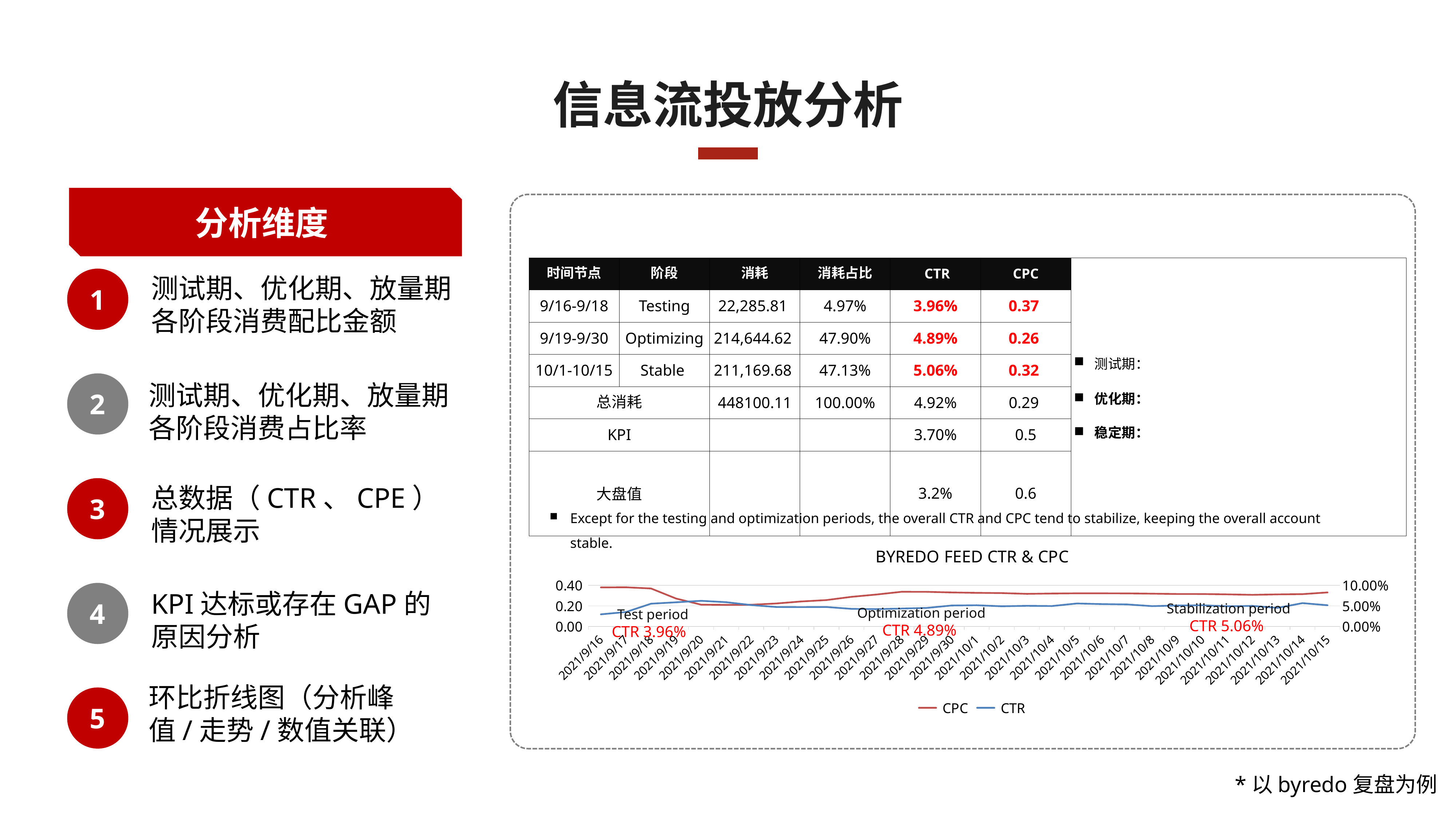
In the BYREDO FEED CTR & CPC chart, is the CPC value on 2021/9/16 greater or less than 0.20? greater How many dates are plotted along the x axis of the BYREDO FEED CTR & CPC chart? 30 How many series does the legend of the BYREDO FEED CTR & CPC chart list? 2 In the BYREDO FEED CTR & CPC chart, which annotated period has the higher CTR: the Test period or the Stabilization period? Stabilization period In the BYREDO FEED CTR & CPC chart, what CTR value is annotated for the Stabilization period? 5.06% In the BYREDO FEED CTR & CPC chart, what CTR value is annotated for the Test period? 3.96% In the BYREDO FEED CTR & CPC chart, what is the difference between the annotated Stabilization period CTR and the Test period CTR? 1.10% What is the title of the line chart on the slide? BYREDO FEED CTR & CPC In the BYREDO FEED CTR & CPC chart, what CTR value is annotated for the Optimization period? 4.89% In the BYREDO FEED CTR & CPC chart, which colour is used for the CPC line? red What kind of chart is the BYREDO FEED CTR & CPC chart? line chart In the BYREDO FEED CTR & CPC chart, does the CPC line rise or fall between 2021/9/16 and 2021/9/19? fall